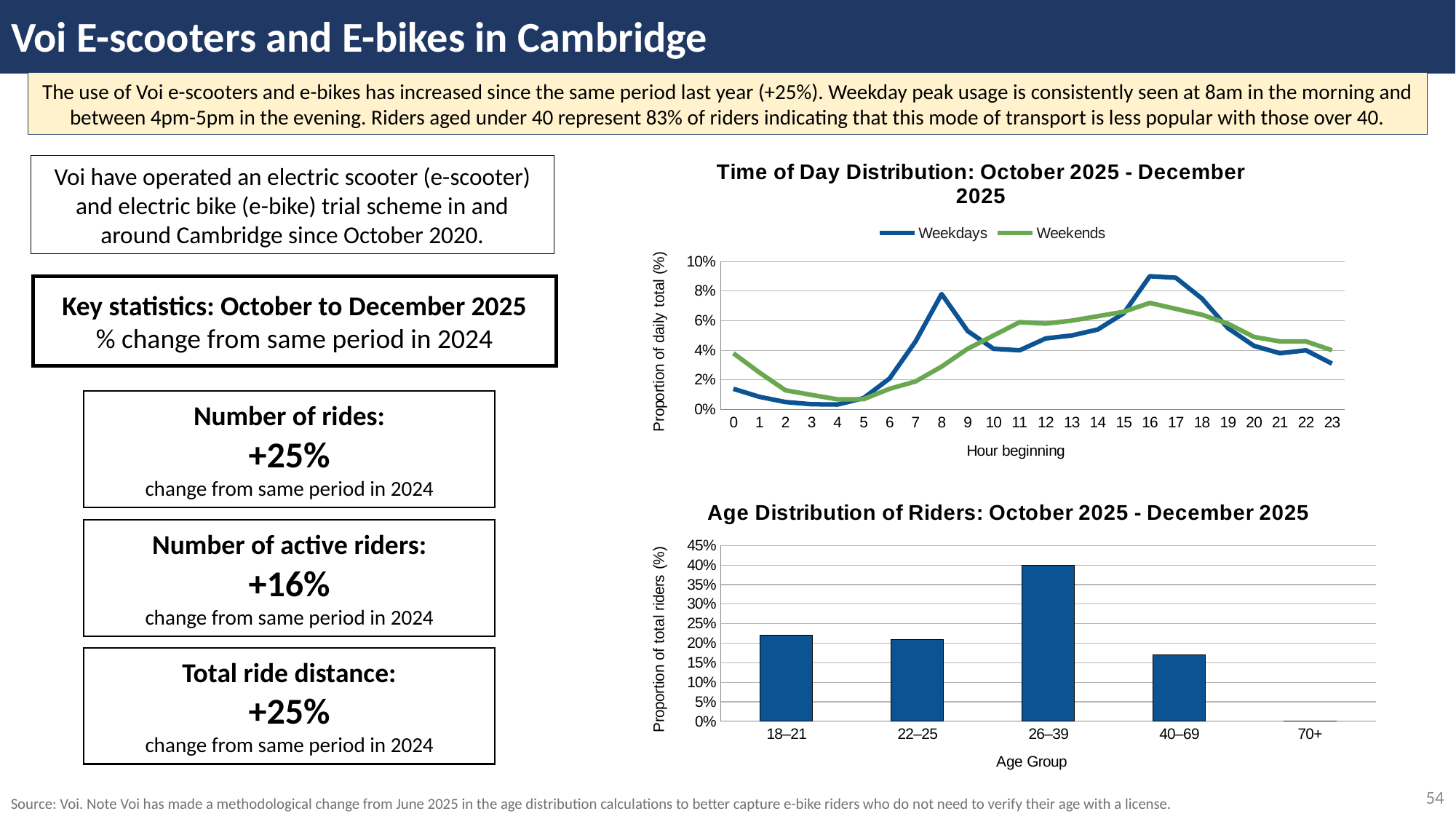
What kind of chart is the 'Age Distribution of Riders: October 2025 - December 2025' chart? Bar chart How many hours are plotted along the x axis of the 'Time of Day Distribution' chart? 24 In the 'Time of Day Distribution' chart, which series has the larger value at hour 11, Weekdays or Weekends? Weekends What kind of chart is the 'Time of Day Distribution: October 2025 - December 2025' chart? Line chart How many age groups are shown in the 'Age Distribution of Riders' chart? 5 In the 'Time of Day Distribution' chart, does the Weekdays series rise or fall between hour 0 and hour 4? Fall How many series does the legend of the 'Time of Day Distribution' chart list? 2 In the 'Age Distribution of Riders' chart, which age group has the highest proportion of total riders? 26–39 In the 'Time of Day Distribution' chart, at which hour does the Weekends series reach its highest value? 16 In the 'Age Distribution of Riders' chart, is the value for the 40–69 age group greater or less than 20%? less In the 'Time of Day Distribution' chart, is the Weekdays value at hour 8 greater or less than 6%? greater In the 'Time of Day Distribution' chart, which series has the larger value at hour 8, Weekdays or Weekends? Weekdays